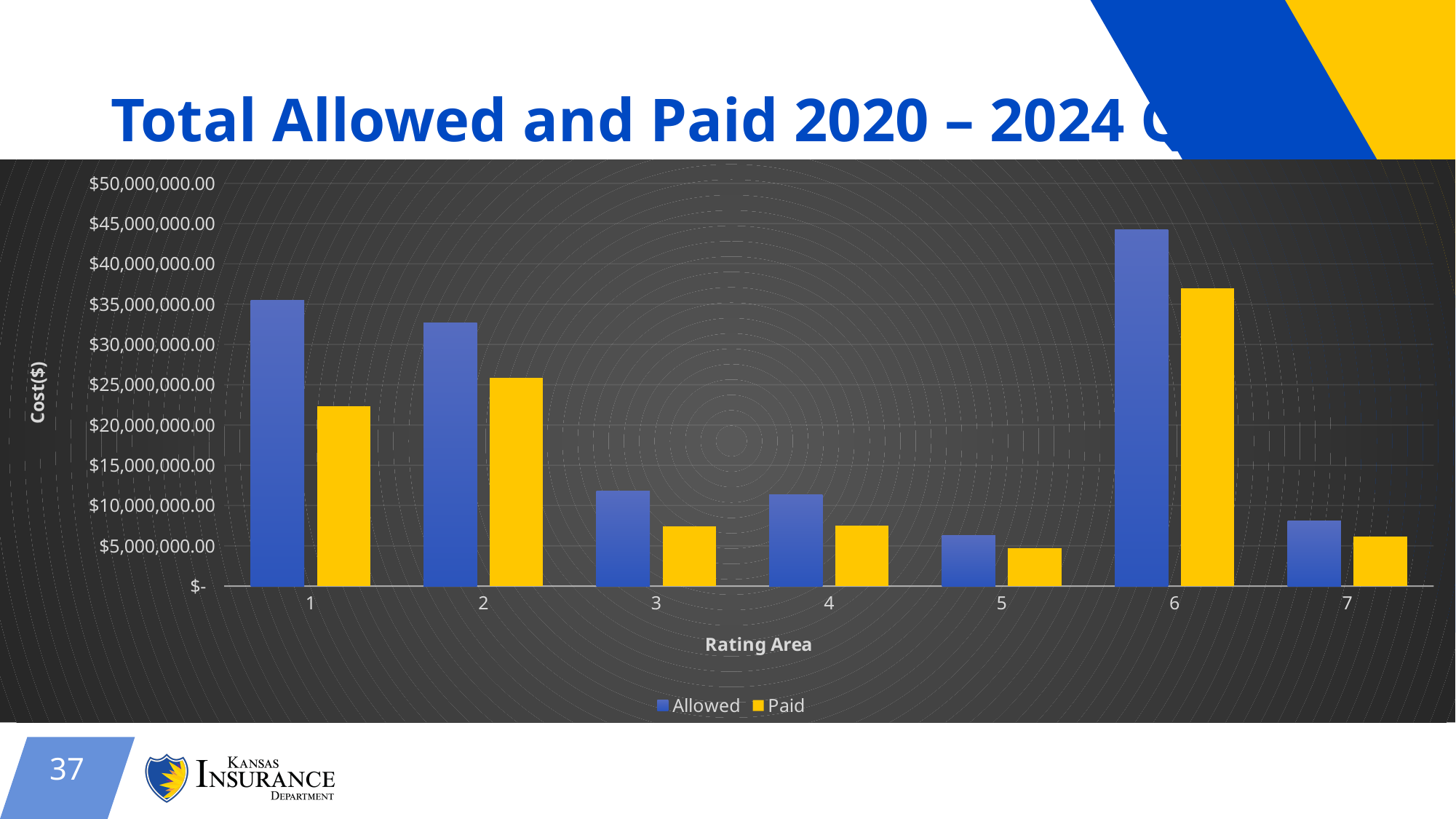
How many rating areas are shown on the x axis? 7 Which is larger, the Paid value for rating area 1 or the Paid value for rating area 2? rating area 2 Which rating area has the lowest Allowed value? 5 Which rating area has the lowest Paid value? 5 Which rating area has the highest Allowed value? 6 Which rating area has the highest Paid value? 6 What kind of chart is shown on the slide? bar chart What is the label of the x axis? Rating Area Is the Allowed value for rating area 6 greater or less than $40,000,000.00? greater Is the Allowed value for rating area 7 greater or less than $10,000,000.00? less How many series does the legend list? 2